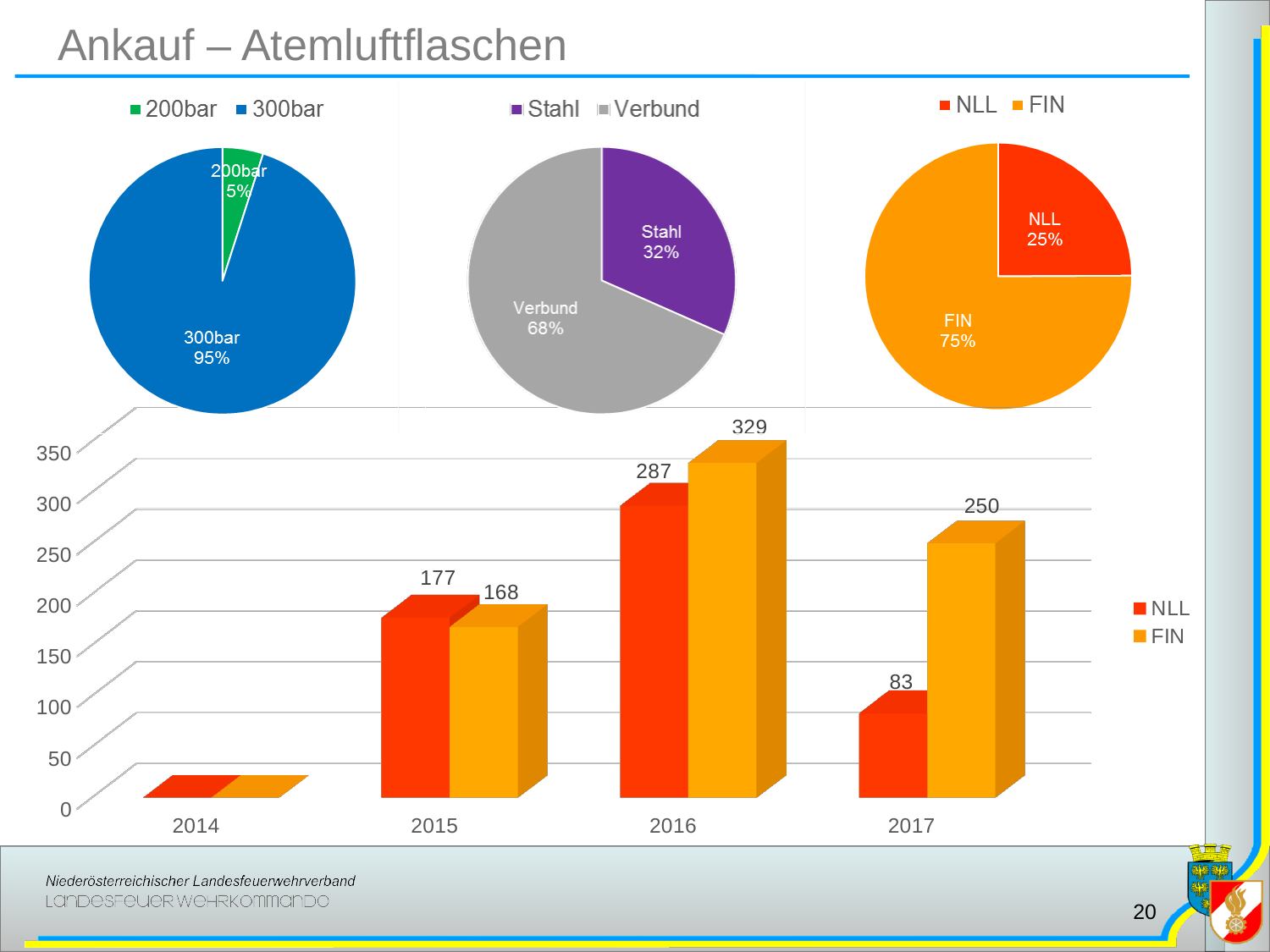
In the pie chart at the top right of the slide, which slice is larger, NLL or FIN? FIN How many series does the legend of the bar chart at the bottom of the slide list? 2 What kind of chart is the chart at the bottom of the slide? bar chart In the bar chart at the bottom of the slide, what is the NLL value for 2016? 287 In the bar chart at the bottom of the slide, what is the FIN value for 2017? 250 In the bar chart at the bottom of the slide, what is the difference between the FIN and NLL values in 2016? 42 In the pie chart at the top left of the slide, what share does 300bar have? 95% In the bar chart at the bottom of the slide, which is larger in 2015, NLL or FIN? NLL In the bar chart at the bottom of the slide, is the NLL value for 2017 greater or less than 100? less In the bar chart at the bottom of the slide, which year has the highest FIN value? 2016 In the pie chart at the top centre of the slide, what share does Verbund have? 68% How many years are shown on the x axis of the bar chart at the bottom of the slide? 4